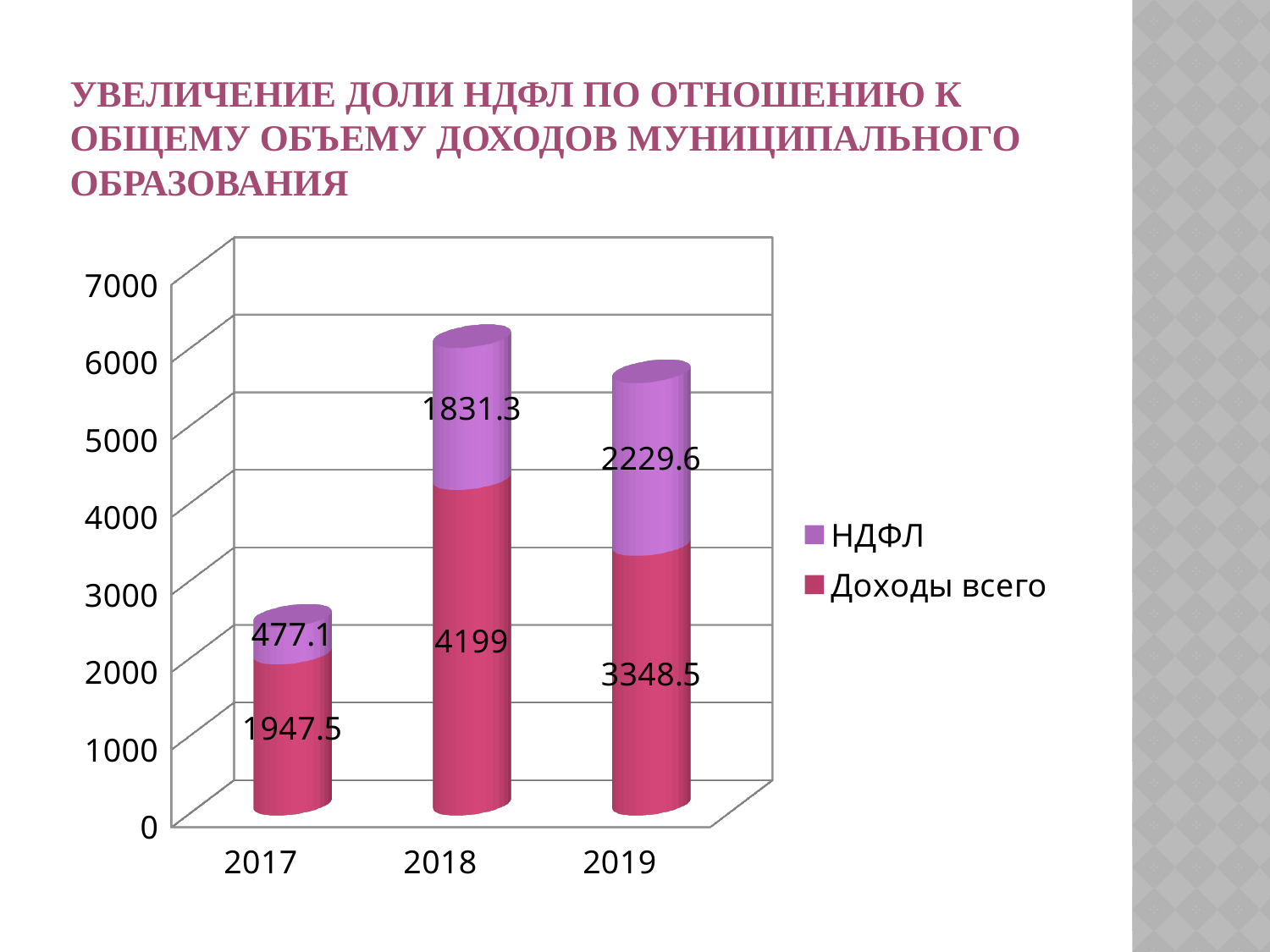
Which is larger: Доходы всего for 2018 or Доходы всего for 2019? Доходы всего for 2018 Which year has the lowest value for НДФЛ? 2017 What kind of chart is shown on the slide? Stacked bar chart What is the total of the stacked bar for 2017? 2424.6 How many years are shown on the x axis? 3 Which year has the highest value for Доходы всего? 2018 What is the value of Доходы всего for 2017? 1947.5 What is the difference between the НДФЛ values for 2019 and 2018? 398.3 How many series does the legend list? 2 What is the value of Доходы всего for 2019? 3348.5 What is the value of НДФЛ for 2019? 2229.6 What is the value of НДФЛ for 2018? 1831.3